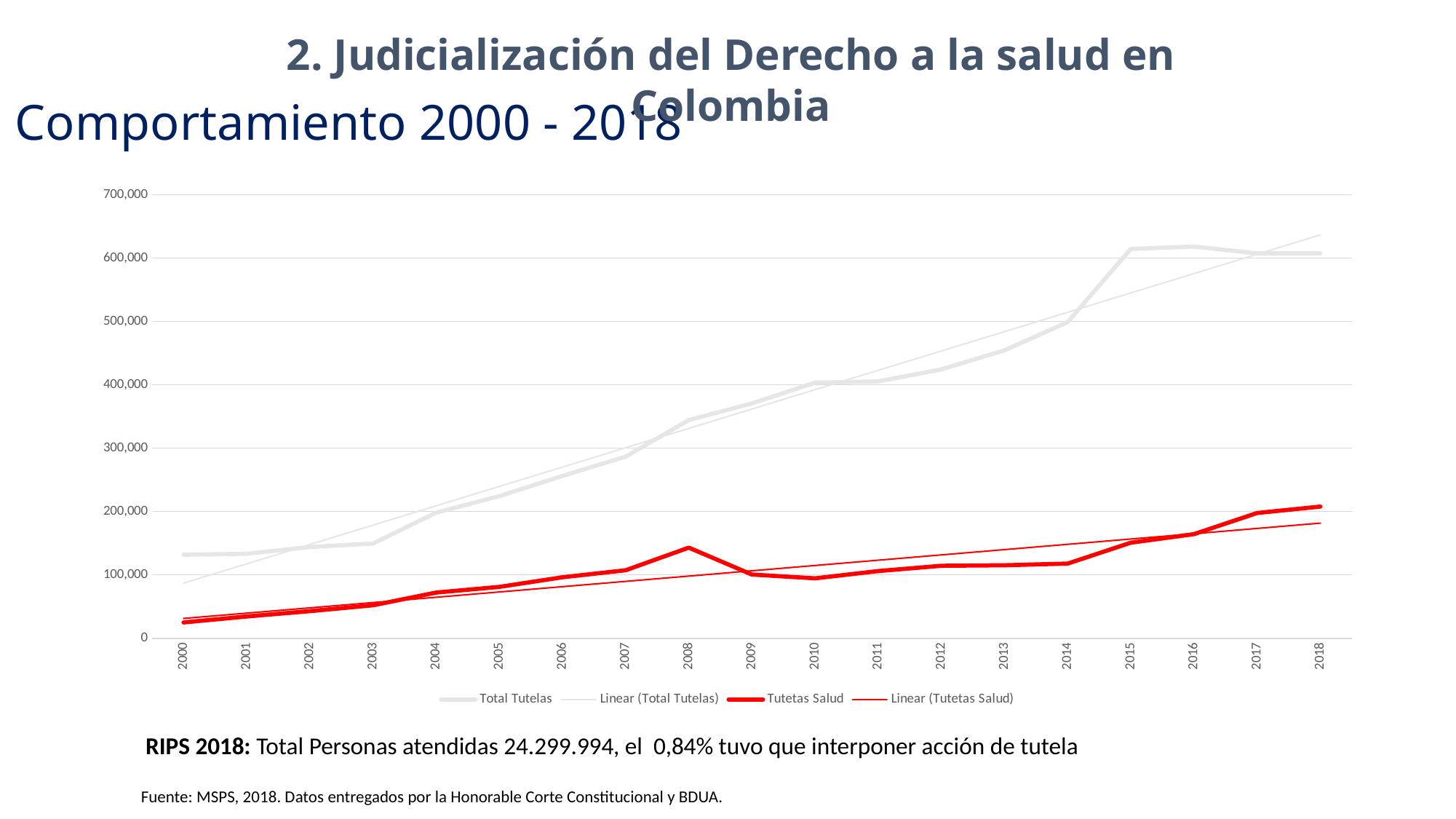
Is the value of Tutelas Salud in 2008 greater or less than 100,000? greater How many years are plotted along the x axis of the chart? 19 Overall, does the Total Tutelas series rise or fall from 2000 to 2018? rise How many entries does the chart's legend list? 4 In which year is the Tutelas Salud series at its lowest? 2000 Is the value of Tutelas Salud in 2000 greater or less than 100,000? less In 2018, which series has the larger value, Total Tutelas or Tutelas Salud? Total Tutelas Is the value of Total Tutelas in 2013 greater or less than 500,000? less What kind of chart is shown on the slide? line chart For Tutelas Salud, which year has the larger value, 2008 or 2009? 2008